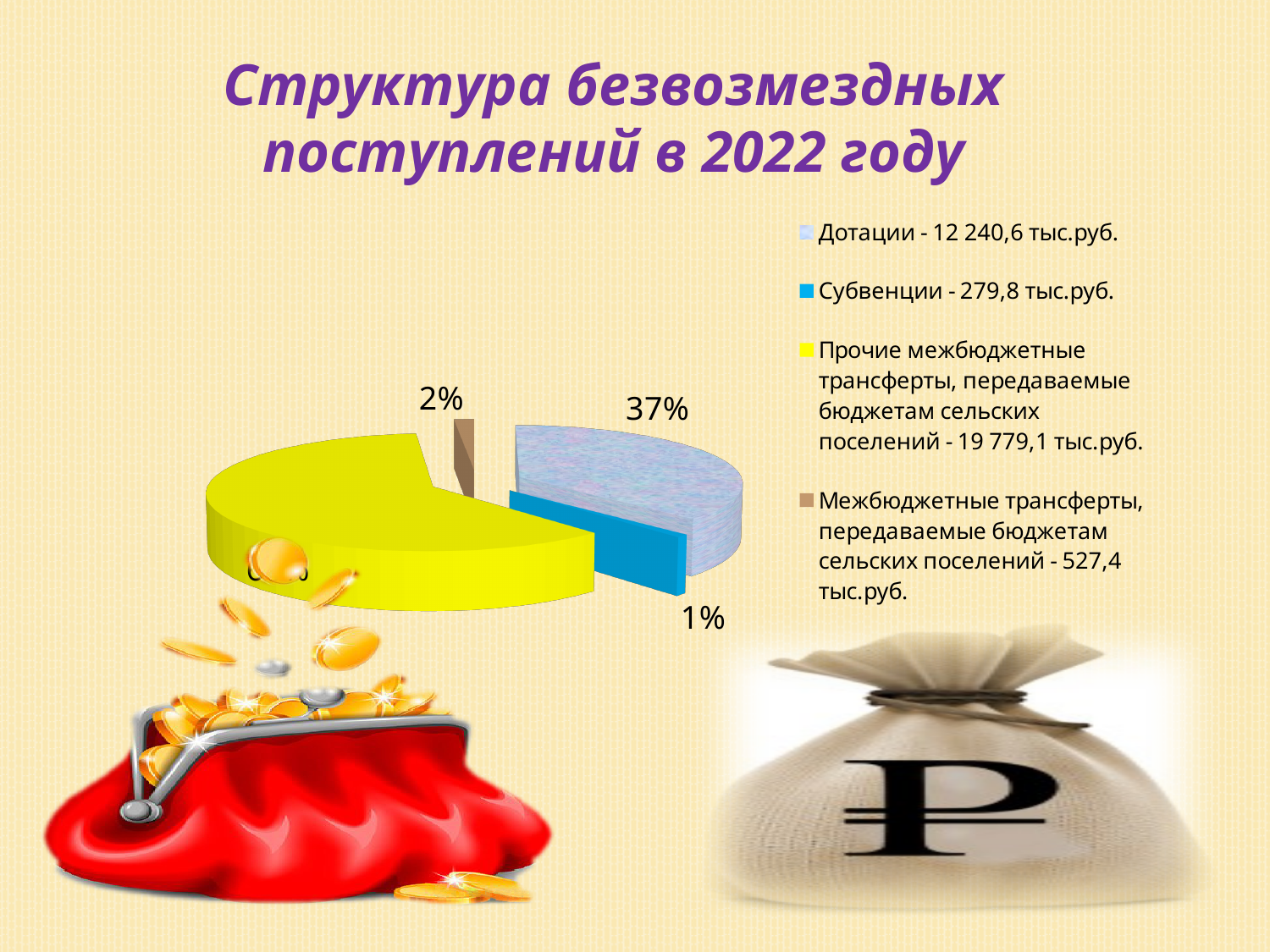
Which is larger: the Субвенции slice or the 'Межбюджетные трансферты, передаваемые бюджетам сельских поселений' slice? Межбюджетные трансферты, передаваемые бюджетам сельских поселений Which slice is the smallest in the pie chart? Субвенции What percentage is shown for the Субвенции slice? 1% What kind of chart is shown on the slide? Pie chart How many entries does the legend list? 4 Which slice is the largest in the pie chart? Прочие межбюджетные трансферты, передаваемые бюджетам сельских поселений According to the legend, what amount is given for Дотации? 12 240,6 тыс.руб. What is the title of the slide containing the chart? Структура безвозмездных поступлений в 2022 году What is the difference in percentage points between the Дотации slice (37%) and the 'Межбюджетные трансферты, передаваемые бюджетам сельских поселений' slice (2%)? 35 percentage points What share of the pie does the Дотации slice represent? 37% How many slices does the pie chart have? 4 What percentage is shown for the slice 'Межбюджетные трансферты, передаваемые бюджетам сельских поселений'? 2%